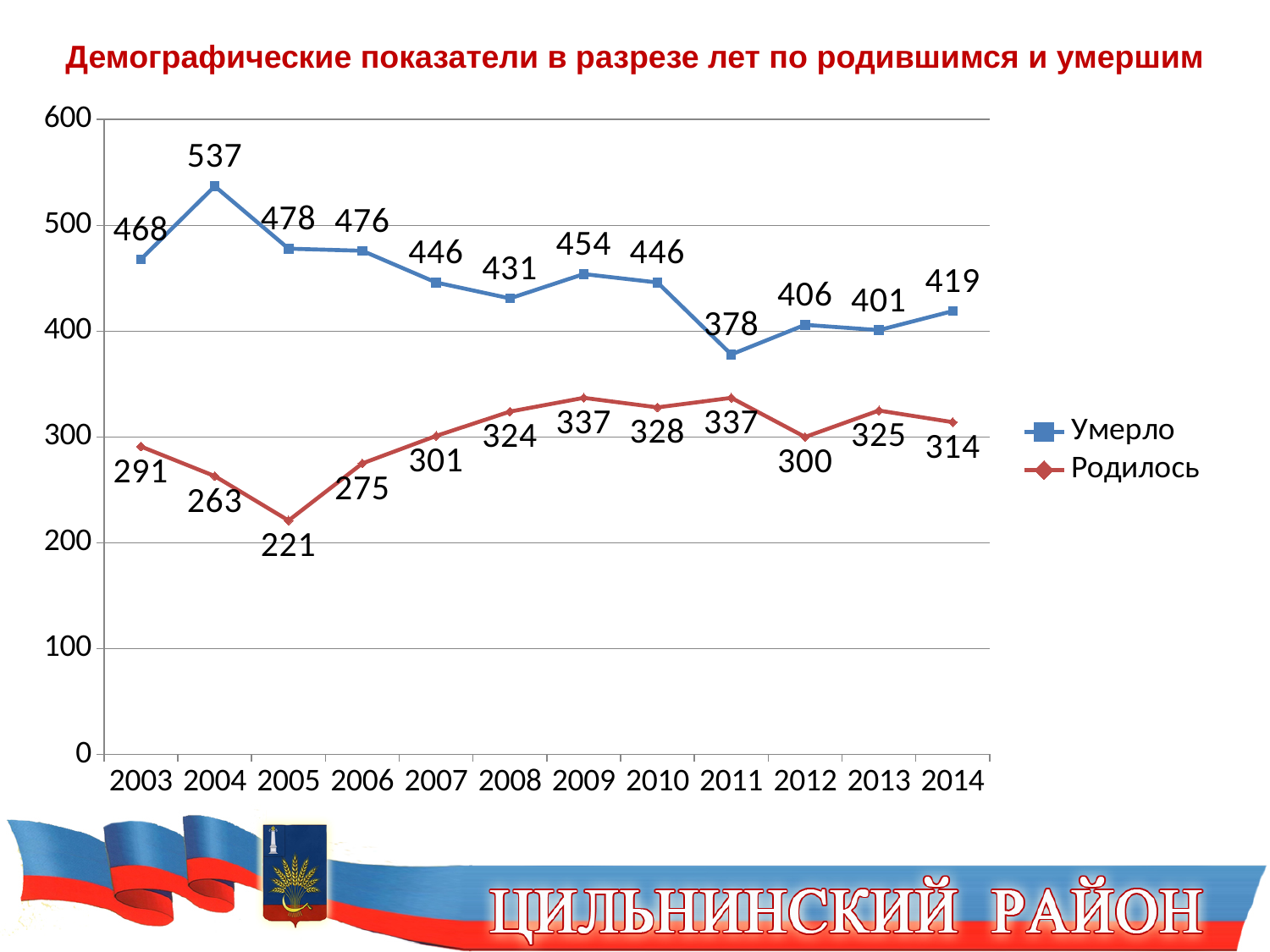
What is the difference between Умерло and Родилось in 2011? 41 What is the value for Умерло in 2004? 537 What is the value for Родилось in 2014? 314 Which is larger in 2009: Умерло or Родилось? Умерло What is the value for Родилось in 2005? 221 In which year is the Умерло series highest? 2004 Does the Умерло series rise or fall from 2004 to 2011? fall In which year is the Родилось series lowest? 2005 What kind of chart is shown on the slide? line chart How many years are shown on the x axis? 12 How many series does the legend list? 2 In which year is the Умерло series lowest? 2011